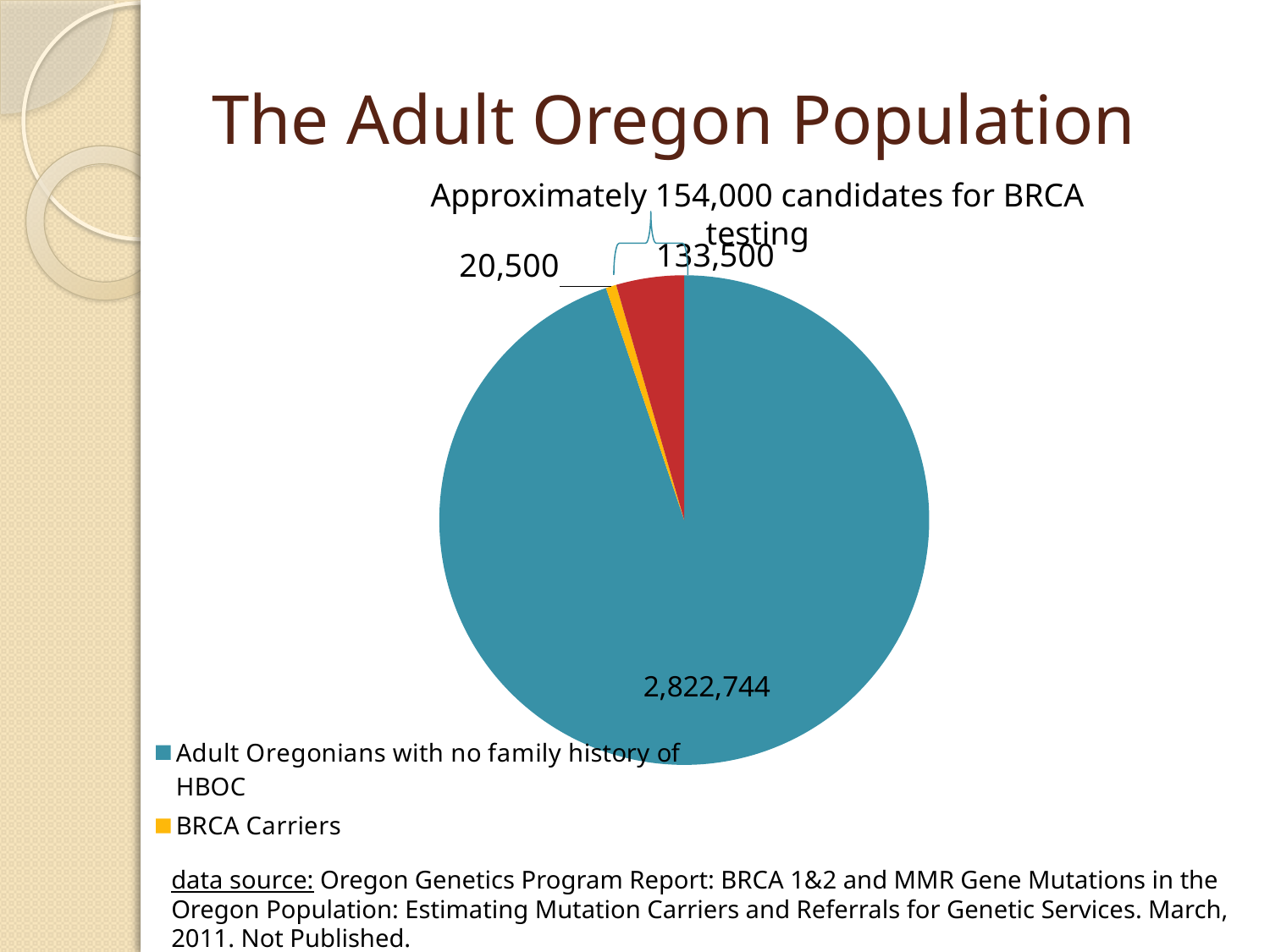
What is the value for Adult Oregonians with no family history of HBOC? 2,822,744 Which is larger, the BRCA Carriers slice or the red slice labelled 133,500? the red slice labelled 133,500 What is the difference between the red slice value (133,500) and the BRCA Carriers value? 113,000 According to the annotation above the pie chart, approximately how many candidates for BRCA testing are there? Approximately 154,000 What is the total of all three slice values in the pie chart? 2,976,744 What value is labelled on the red slice of the pie chart? 133,500 Which slice of the pie chart is the smallest? BRCA Carriers What kind of chart is shown on the slide? pie chart How many slices does the pie chart have? 3 What is the value for BRCA Carriers? 20,500 How many entries does the legend list? 2 Which slice of the pie chart is the largest? Adult Oregonians with no family history of HBOC